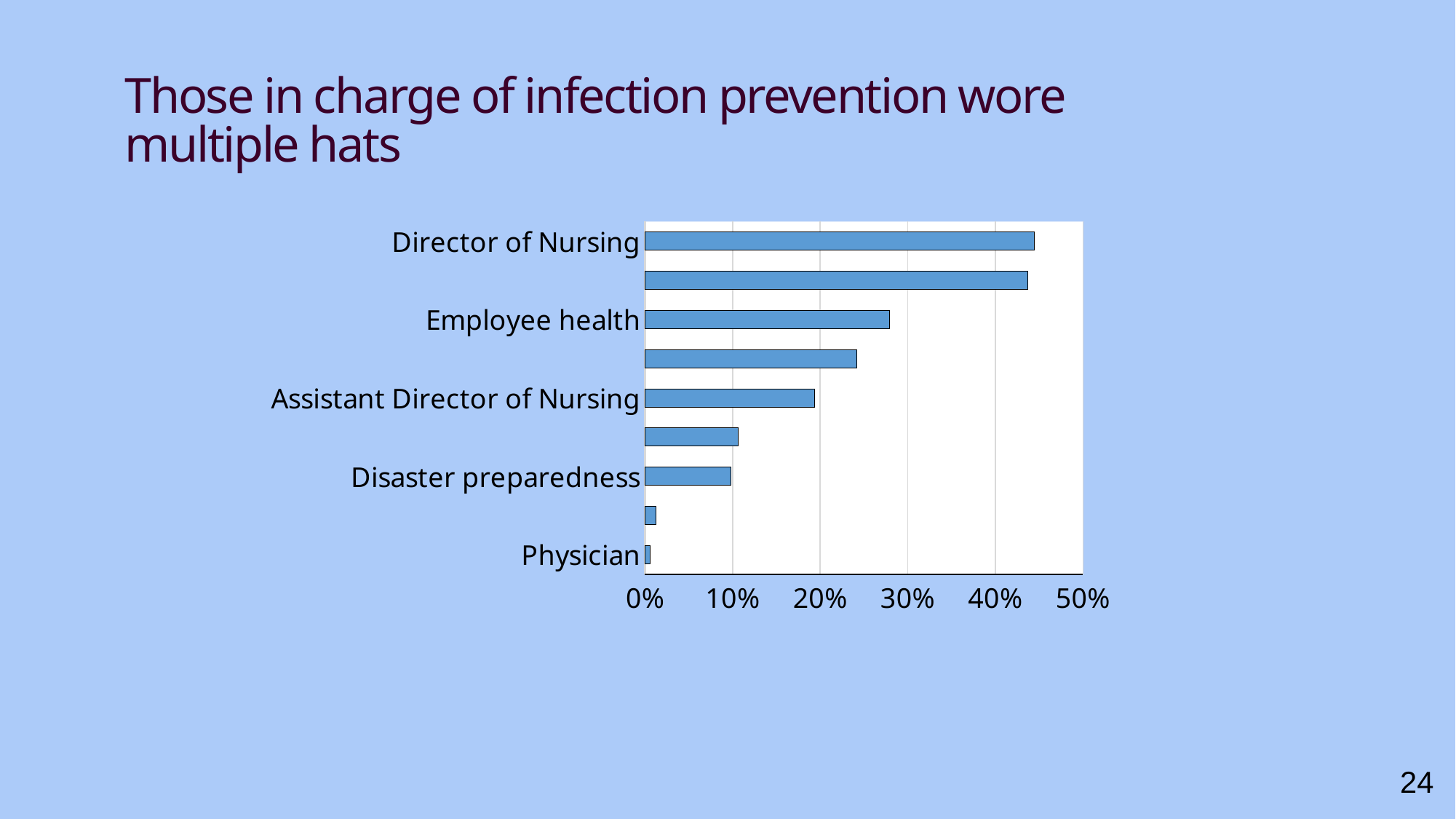
Do the bar values increase or decrease going from the top of the chart to the bottom? Decrease Is the value for Assistant Director of Nursing greater or less than 20%? less Which labeled category has the lowest value in the chart? Physician What kind of chart is shown on the slide? Bar chart How many bars are plotted in the chart? 9 Which is larger, the value for Employee health or the value for Assistant Director of Nursing? Employee health Which is larger, the value for Disaster preparedness or the value for Director of Nursing? Director of Nursing What is the highest value shown on the horizontal axis of the chart? 50% Is the value for Physician greater or less than 10%? less Is the value for Disaster preparedness greater or less than 20%? less